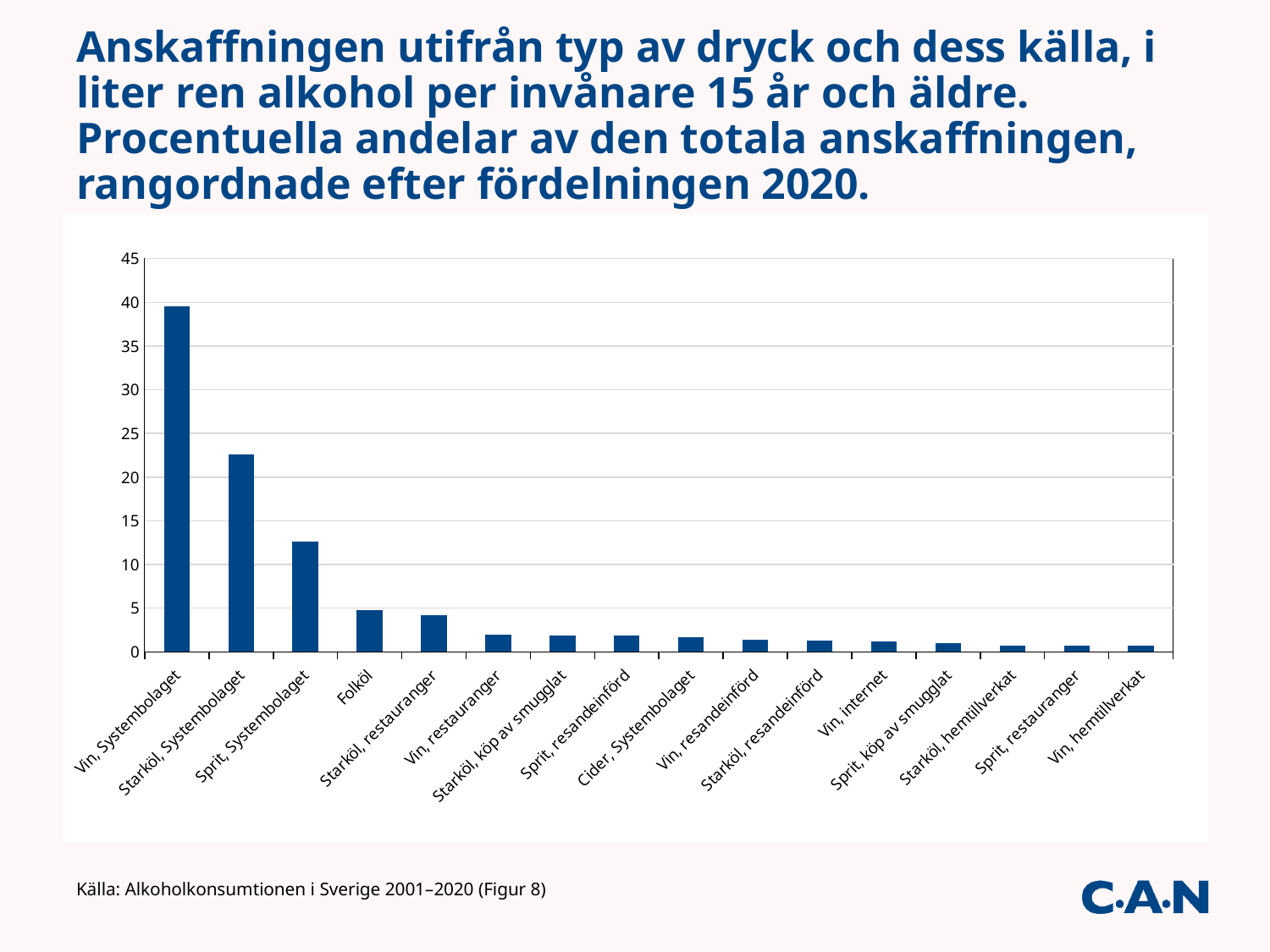
What kind of chart is shown on the slide? bar chart Which category has the highest bar? Vin, Systembolaget What is the highest value shown on the y axis? 45 Is the value for Sprit, Systembolaget greater or less than 15? less Is the value for Vin, restauranger greater or less than 5? less Is the value for Starköl, Systembolaget greater or less than 20? greater How many categories are plotted on the x axis? 16 Which is larger, the value for Folköl or the value for Vin, internet? Folköl Which is larger, the value for Starköl, Systembolaget or the value for Sprit, Systembolaget? Starköl, Systembolaget Do the bar values rise or fall from left to right along the x axis? fall